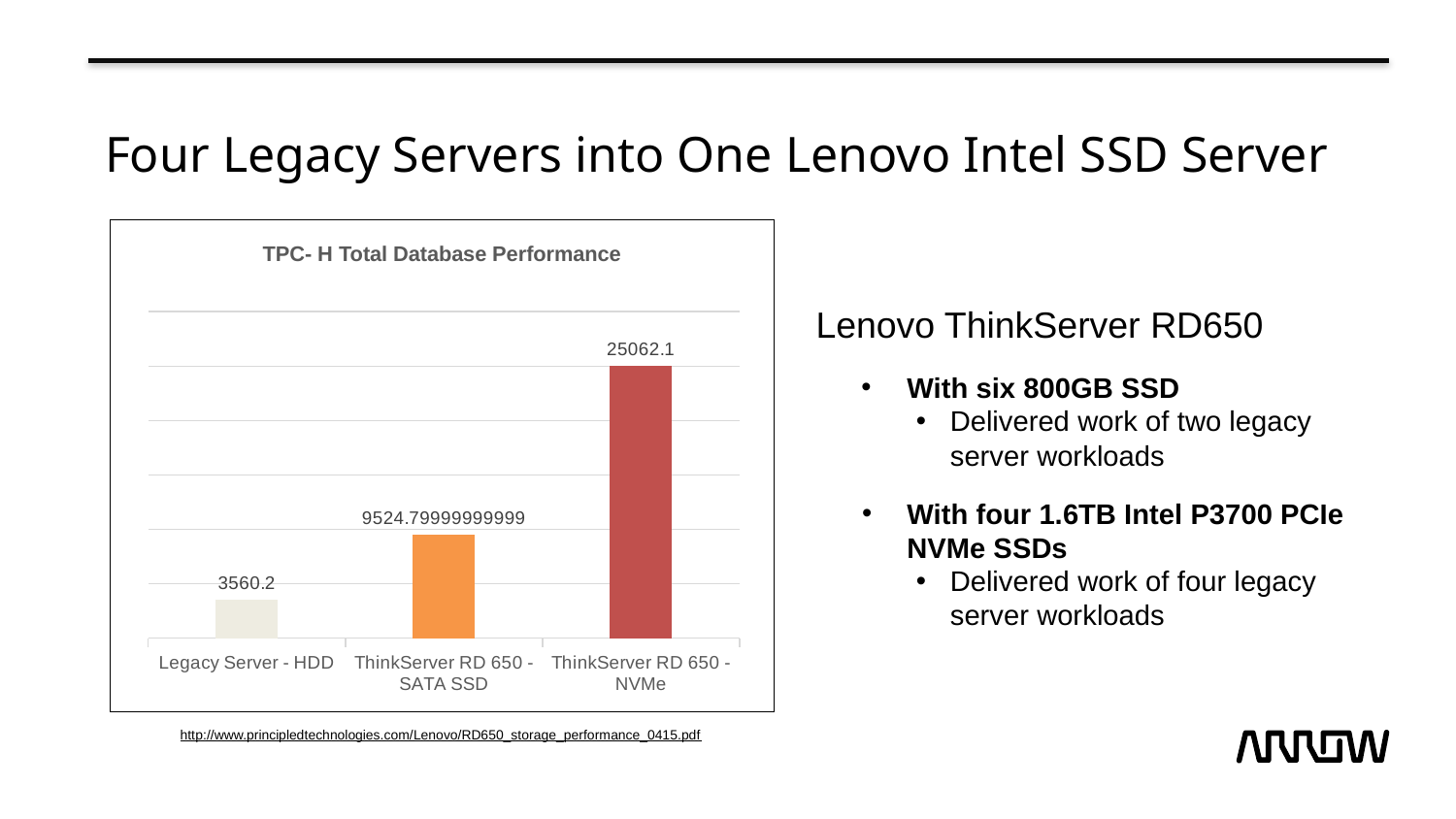
Which category has the highest value in the TPC- H Total Database Performance chart? ThinkServer RD 650 - NVMe What is the difference between the ThinkServer RD 650 - NVMe value and the Legacy Server - HDD value in the TPC- H Total Database Performance chart? 21501.9 What colour is the bar for ThinkServer RD 650 - NVMe in the TPC- H Total Database Performance chart? Red How many categories are shown in the TPC- H Total Database Performance chart? 3 What is the title of the chart on the slide? TPC- H Total Database Performance What is the value for ThinkServer RD 650 - SATA SSD in the TPC- H Total Database Performance chart? 9524.79999999999 Which is larger in the TPC- H Total Database Performance chart: ThinkServer RD 650 - SATA SSD or Legacy Server - HDD? ThinkServer RD 650 - SATA SSD Do the values rise or fall from left to right across the categories in the TPC- H Total Database Performance chart? Rise What is the value for Legacy Server - HDD in the TPC- H Total Database Performance chart? 3560.2 What kind of chart is the TPC- H Total Database Performance chart? Bar chart Which category has the lowest value in the TPC- H Total Database Performance chart? Legacy Server - HDD What is the value for ThinkServer RD 650 - NVMe in the TPC- H Total Database Performance chart? 25062.1